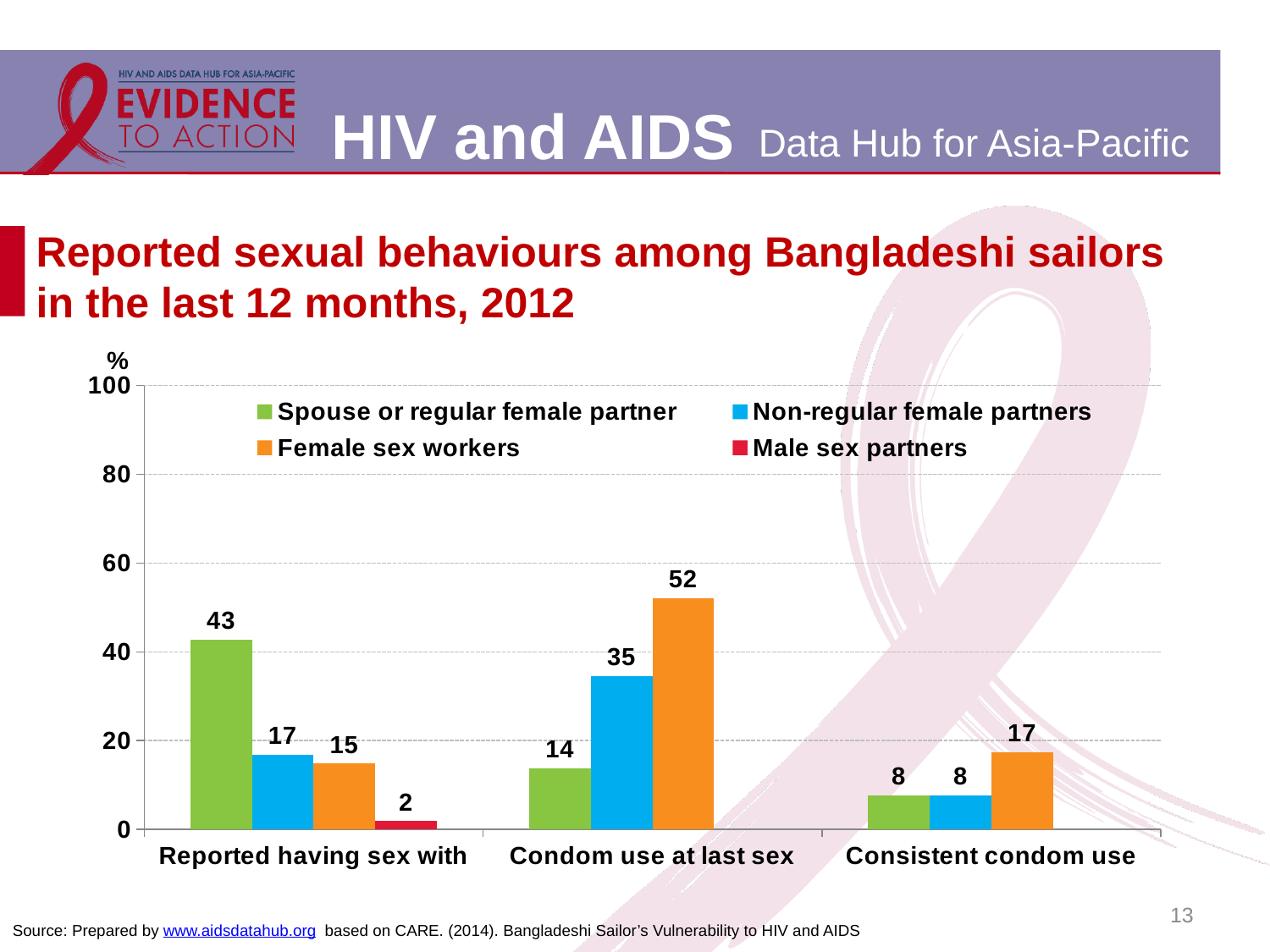
What kind of chart is shown on the slide? Bar chart Which partner type has the highest value for condom use at last sex? Female sex workers What is the value for condom use at last sex with female sex workers? 52 What is the difference between condom use at last sex with female sex workers and with spouse or regular female partner? 38 Which partner type has the lowest value in the 'Reported having sex with' category? Male sex partners What percentage of sailors reported having sex with a spouse or regular female partner? 43 What colour represents female sex workers in the chart? Orange How many series does the legend list? 4 What is the value for consistent condom use with non-regular female partners? 8 Which is larger: reported having sex with non-regular female partners or with female sex workers? Non-regular female partners What percentage of sailors reported having sex with male sex partners? 2 How many categories are shown on the x axis? 3